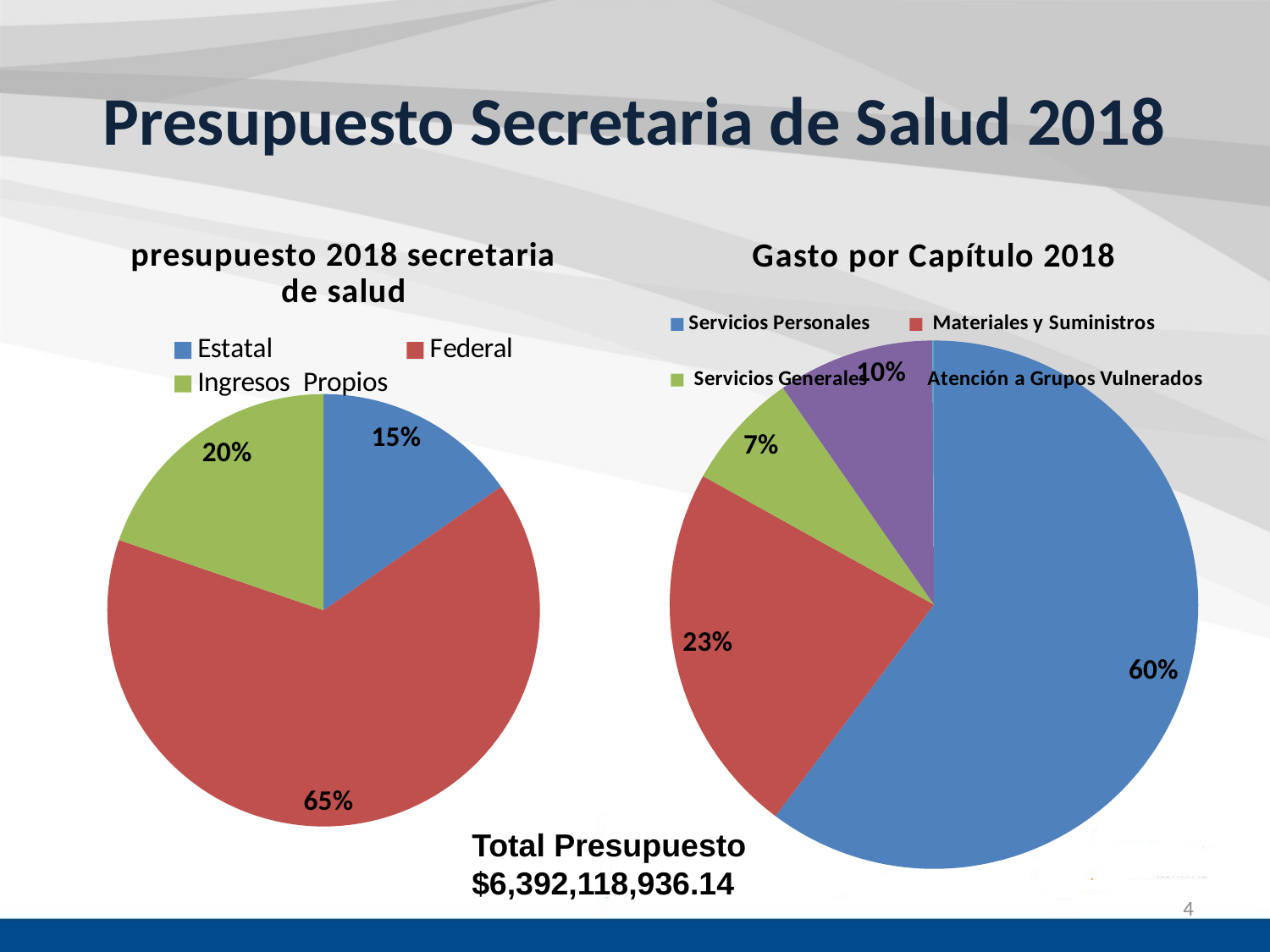
In the 'Gasto por Capítulo 2018' chart, what share does Materiales y Suministros have? 23% In the 'Gasto por Capítulo 2018' chart, how many categories does the legend list? 4 In the 'presupuesto 2018 secretaria de salud' chart, what share does Federal have? 65% In the 'Gasto por Capítulo 2018' chart, which category has the smallest share? Servicios Generales In the 'presupuesto 2018 secretaria de salud' chart, how many slices does the pie have? 3 In the 'presupuesto 2018 secretaria de salud' chart, which category has the smallest share? Estatal What total budget amount is printed on the slide? $6,392,118,936.14 In the 'presupuesto 2018 secretaria de salud' chart, what share does Ingresos Propios have? 20% In the 'Gasto por Capítulo 2018' chart, what share does Servicios Personales have? 60% In the 'presupuesto 2018 secretaria de salud' chart, what is the difference between the Federal and Estatal shares? 50% In the 'Gasto por Capítulo 2018' chart, which is larger, Atención a Grupos Vulnerados or Servicios Generales? Atención a Grupos Vulnerados What kind of chart is the 'presupuesto 2018 secretaria de salud' chart? Pie chart